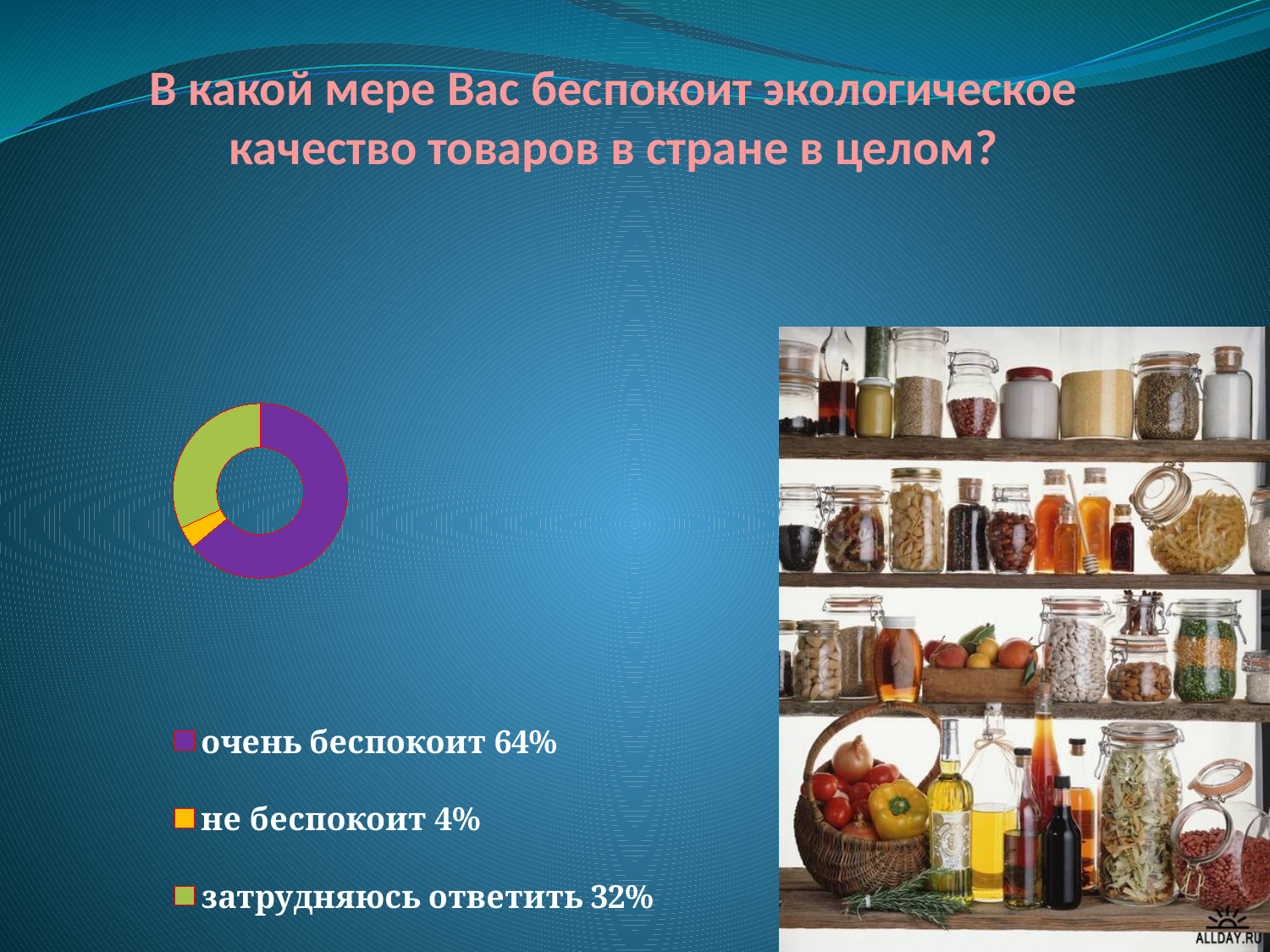
Which answer option has the largest share in the chart? очень беспокоит What colour represents "очень беспокоит" in the chart? purple How many answer categories are shown in the chart? 3 Which is larger: the share for "затрудняюсь ответить" or the share for "не беспокоит"? затрудняюсь ответить What share of respondents answered "не беспокоит"? 4% What share of respondents answered "затрудняюсь ответить"? 32% What is the difference in percentage points between "очень беспокоит" and "затрудняюсь ответить"? 32 What share of respondents answered "очень беспокоит"? 64% What kind of chart is shown on the slide? doughnut (pie) chart What is the difference in percentage points between "затрудняюсь ответить" and "не беспокоит"? 28 What colour represents "не беспокоит" in the chart? orange Which answer option has the smallest share in the chart? не беспокоит